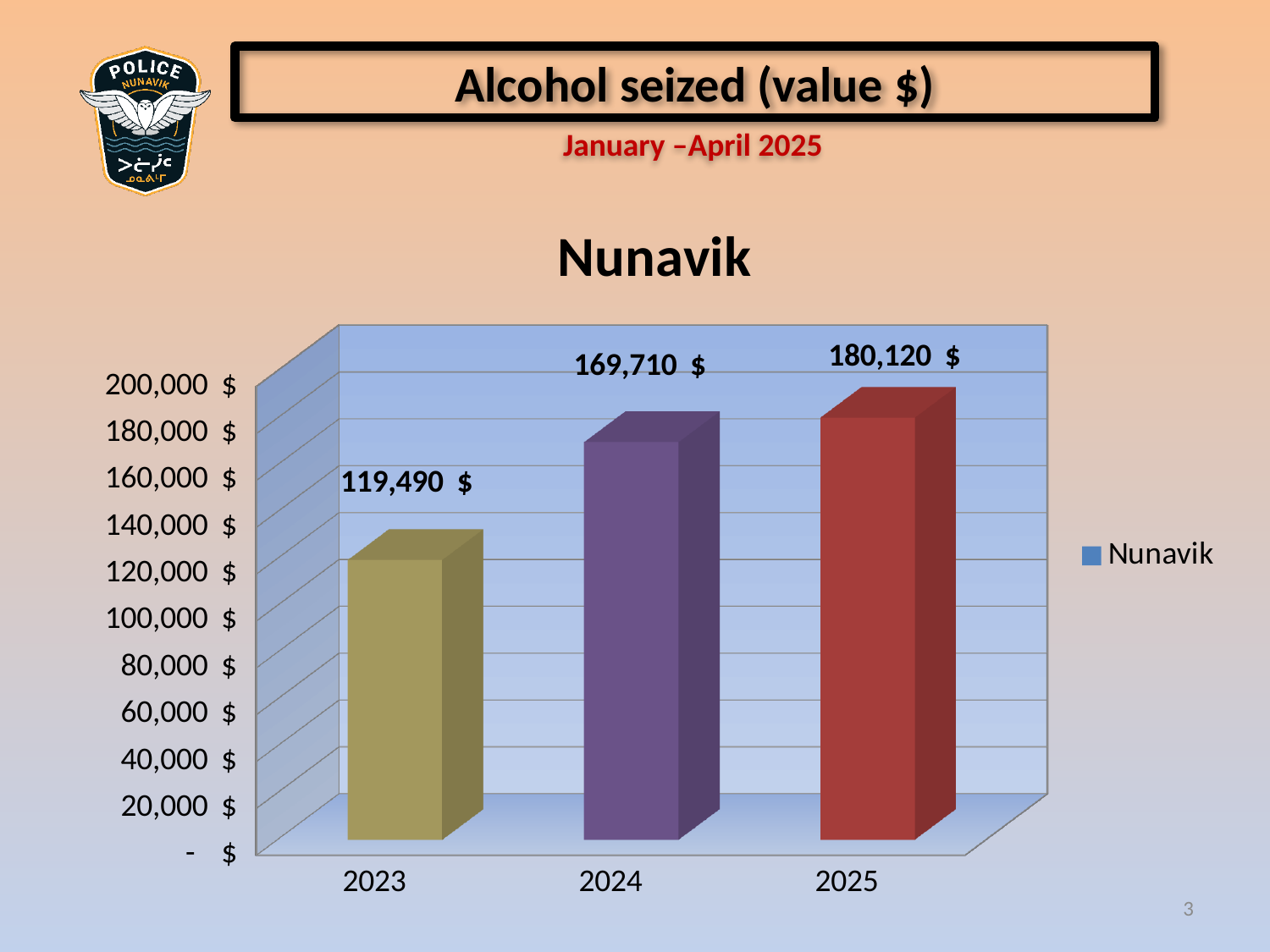
Which year has a larger value of alcohol seized, 2023 or 2024? 2024 What is the value of alcohol seized in Nunavik for 2025? 180,120 $ How many years are shown on the chart? 3 Which year has the highest value of alcohol seized? 2025 Do the values of alcohol seized rise or fall from 2023 to 2025? Rise What is the title of the chart? Nunavik What kind of chart is shown on the slide? Bar chart What is the value of alcohol seized in Nunavik for 2024? 169,710 $ What is the value of alcohol seized in Nunavik for 2023? 119,490 $ Which year has the lowest value of alcohol seized? 2023 What is the difference between the 2024 and 2023 values of alcohol seized? 50,220 $ What is the difference between the 2025 and 2024 values of alcohol seized? 10,410 $